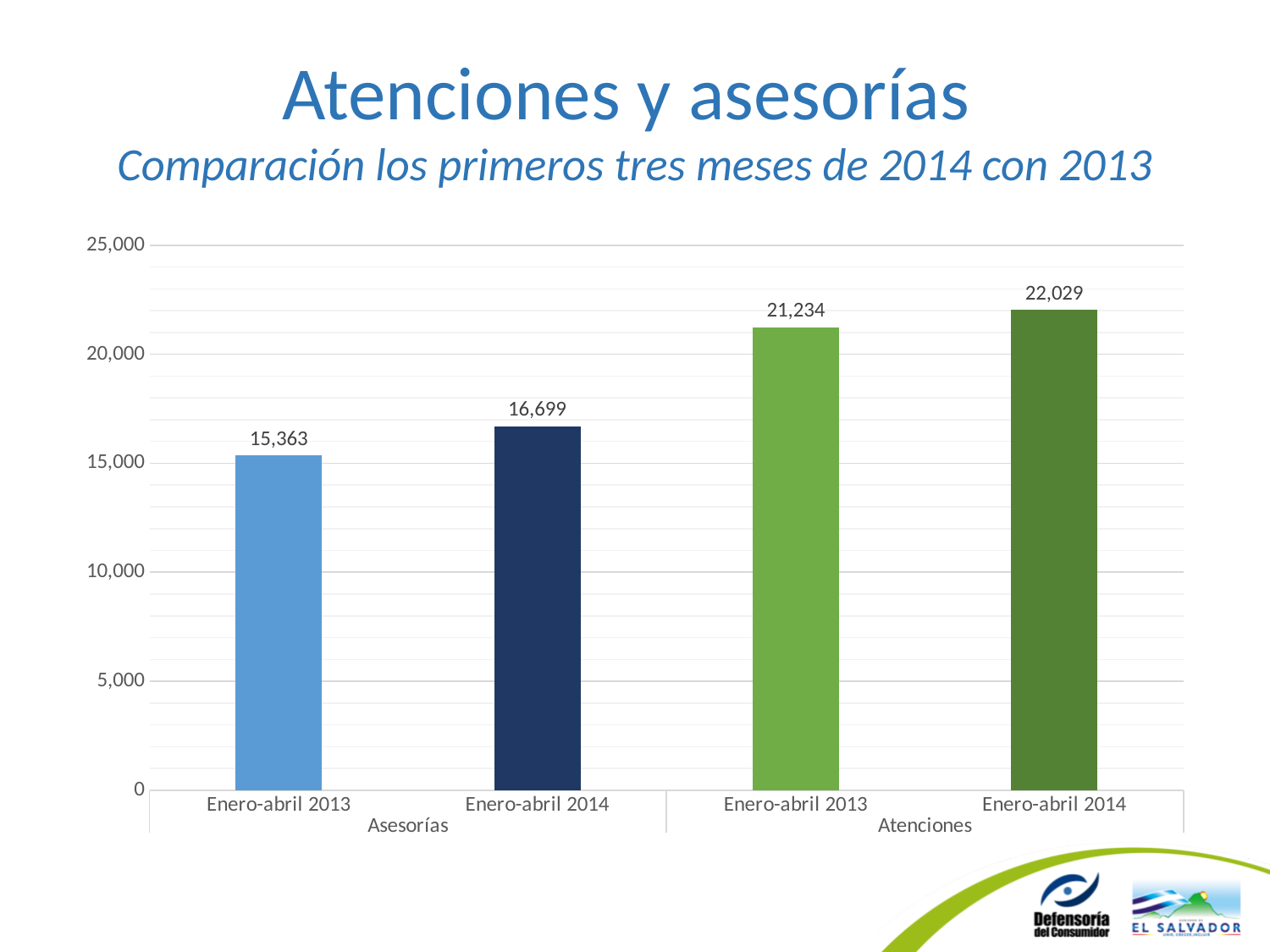
What is the value for Asesorías in Enero-abril 2013? 15,363 What is the difference between Asesorías in Enero-abril 2014 and Enero-abril 2013? 1,336 Which is larger: Asesorías in Enero-abril 2014 or Atenciones in Enero-abril 2013? Atenciones in Enero-abril 2013 Which bar has the highest value? Atenciones, Enero-abril 2014 Is the value for Atenciones in Enero-abril 2013 greater or less than 20,000? greater What is the difference between Atenciones in Enero-abril 2014 and Enero-abril 2013? 795 What is the value for Atenciones in Enero-abril 2013? 21,234 Which bar has the lowest value? Asesorías, Enero-abril 2013 What is the value for Atenciones in Enero-abril 2014? 22,029 What kind of chart is shown on the slide? Bar chart What is the value for Asesorías in Enero-abril 2014? 16,699 How many bars are plotted in the chart? 4